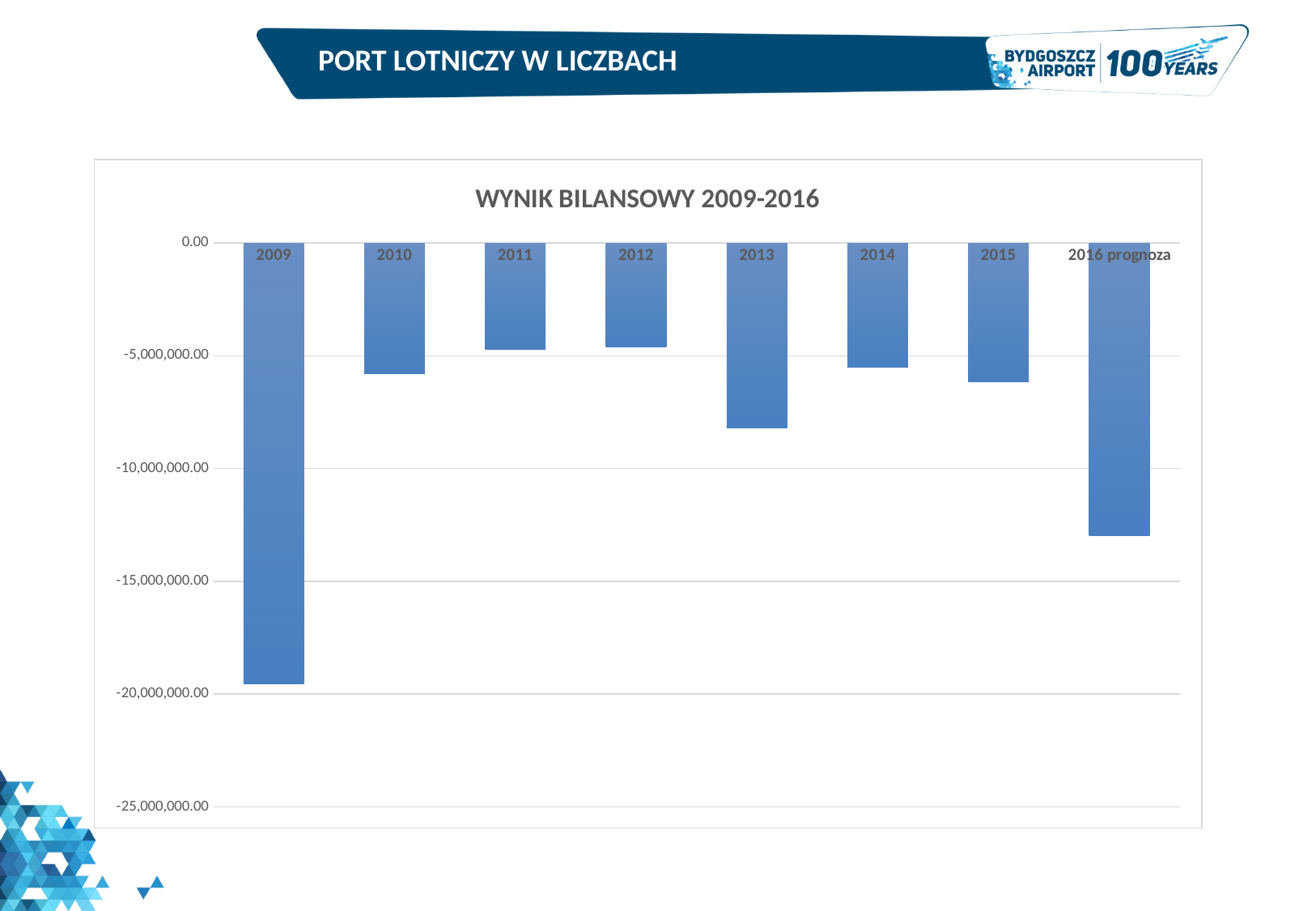
Which bar extends further below zero, 2013 or 2014? 2013 How many bars (categories) are plotted in the chart? 8 What is the title of the chart? WYNIK BILANSOWY 2009-2016 Is the value for 2010 greater or less than -5,000,000.00? less Which category has the lowest (most negative) value? 2009 What type of chart is shown on the slide? bar chart Which bar extends further below zero, 2016 prognoza or 2015? 2016 prognoza What is the label of the last category on the x axis? 2016 prognoza Is the value for 2009 greater or less than -15,000,000.00? less Is the value for 2016 prognoza greater or less than -10,000,000.00? less